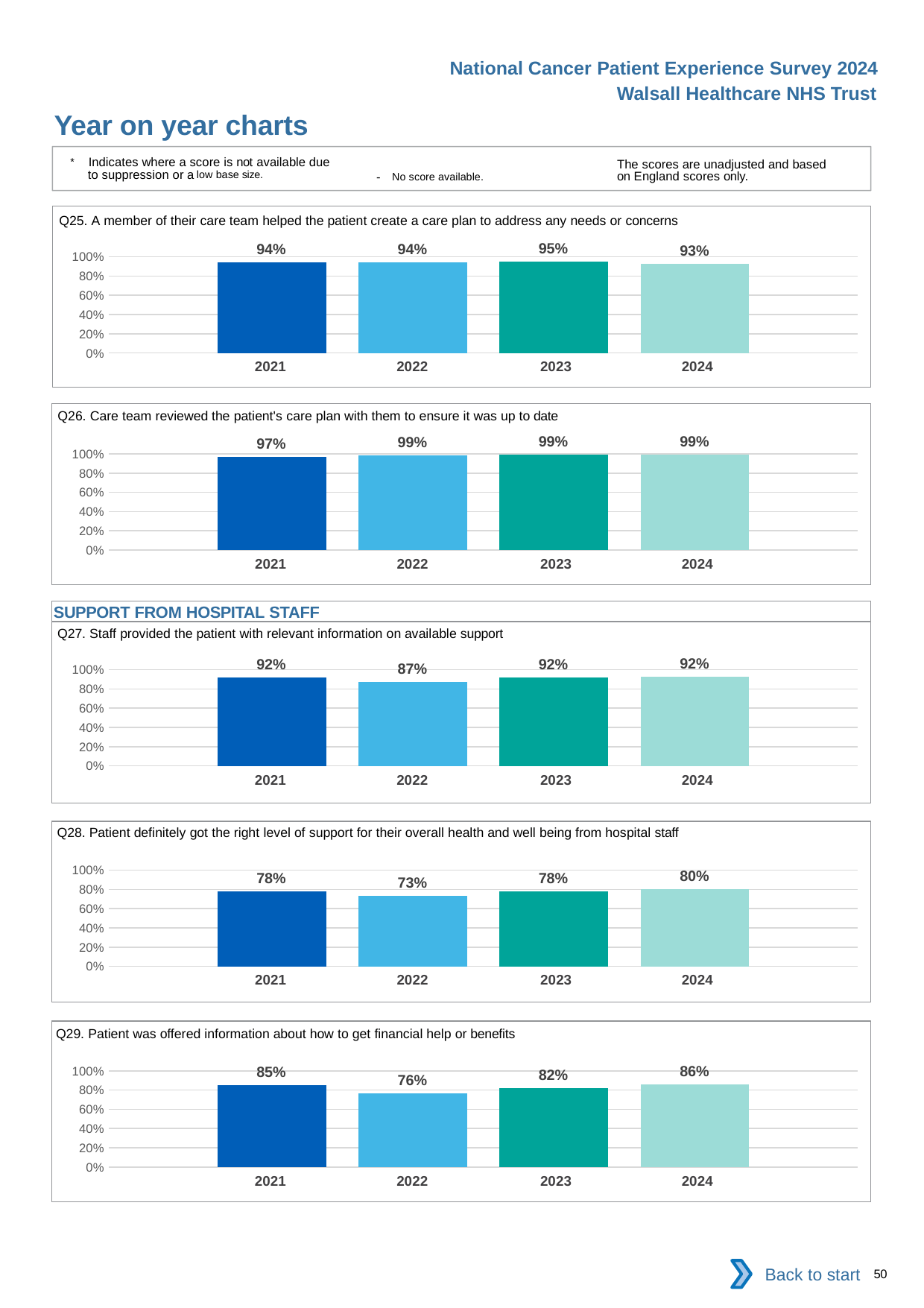
In the Q26 chart, what is the value for 2021? 97% In the Q26 chart, what is the difference between the 2022 value and the 2021 value? 2% In the Q25 chart, what is the value for 2023? 95% In the Q28 chart, which year has the highest value? 2024 In the Q28 chart, what is the difference between the 2024 value and the 2022 value? 7% In the Q27 chart, what is the value for 2024? 92% In the Q27 chart, which year has the lowest value? 2022 How many years are shown on the x axis of the Q29 chart? 4 What kind of chart is the Q28 chart? Bar chart In the Q25 chart, which year has the lowest value? 2024 In the Q29 chart, which is larger, the value for 2021 or the value for 2023? 2021 In the Q29 chart, what is the value for 2022? 76%